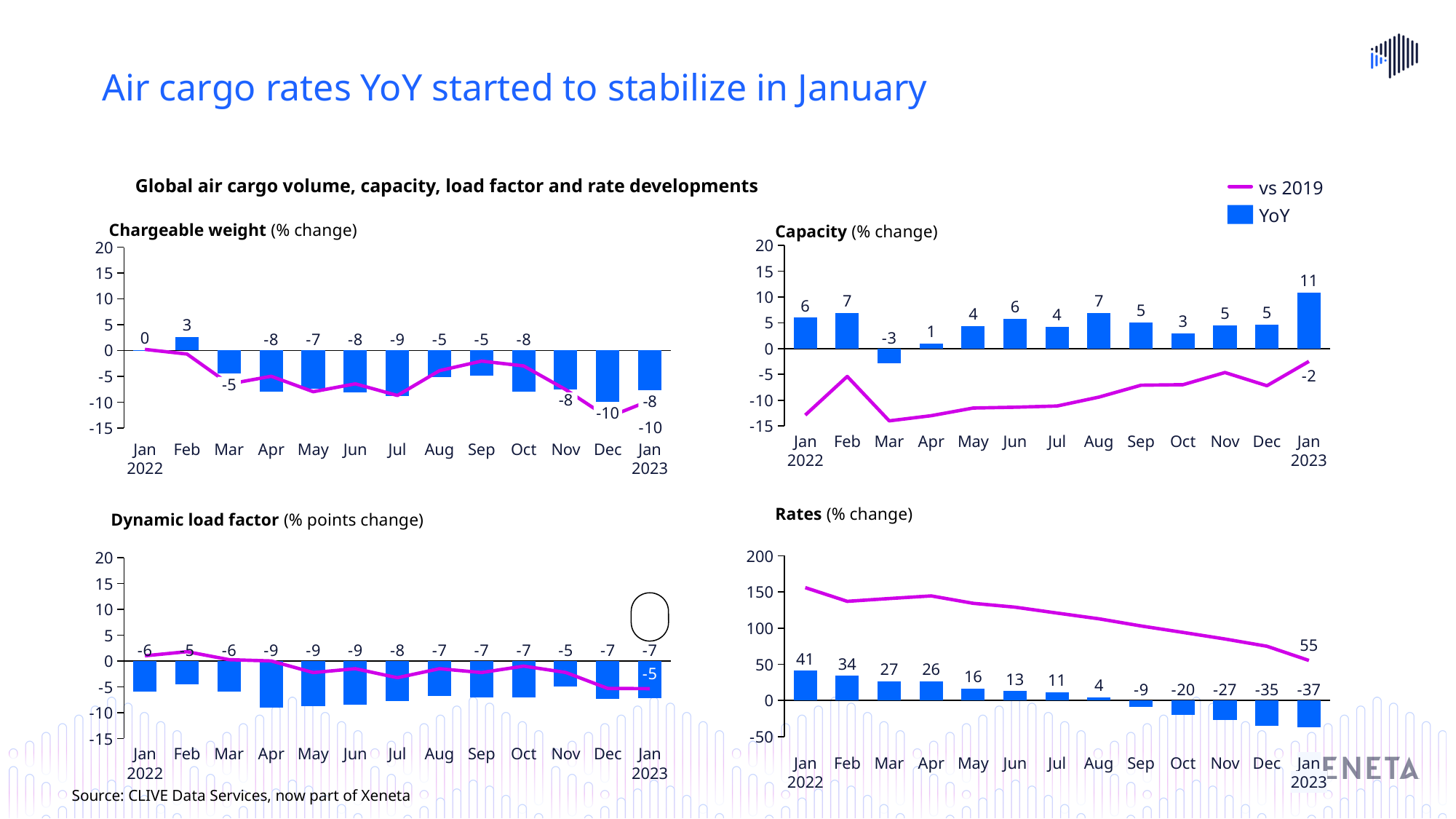
In the Capacity chart, which is larger, the YoY value for Aug or for Oct? Aug How many months are plotted on the x axis of the Capacity chart? 13 In the Rates chart, what is the YoY value for Jan 2022? 41 In the Capacity chart, which month has the lowest YoY value? Mar In the Rates chart, what is the difference between the YoY values for Jan 2022 and Jan 2023? 78 In the Chargeable weight chart, what is the YoY value for Feb? 3 In the Rates chart, what is the vs 2019 value labelled for Jan 2023? 55 In the Capacity chart, which month has the highest YoY value? Jan 2023 In the Rates chart, do the YoY bar values rise or fall from Jan 2022 to Jan 2023? fall In the Dynamic load factor chart, what is the value labelled for Apr? -9 How many series does the legend list? 2 In the Capacity chart, what is the vs 2019 value labelled for Jan 2023? -2